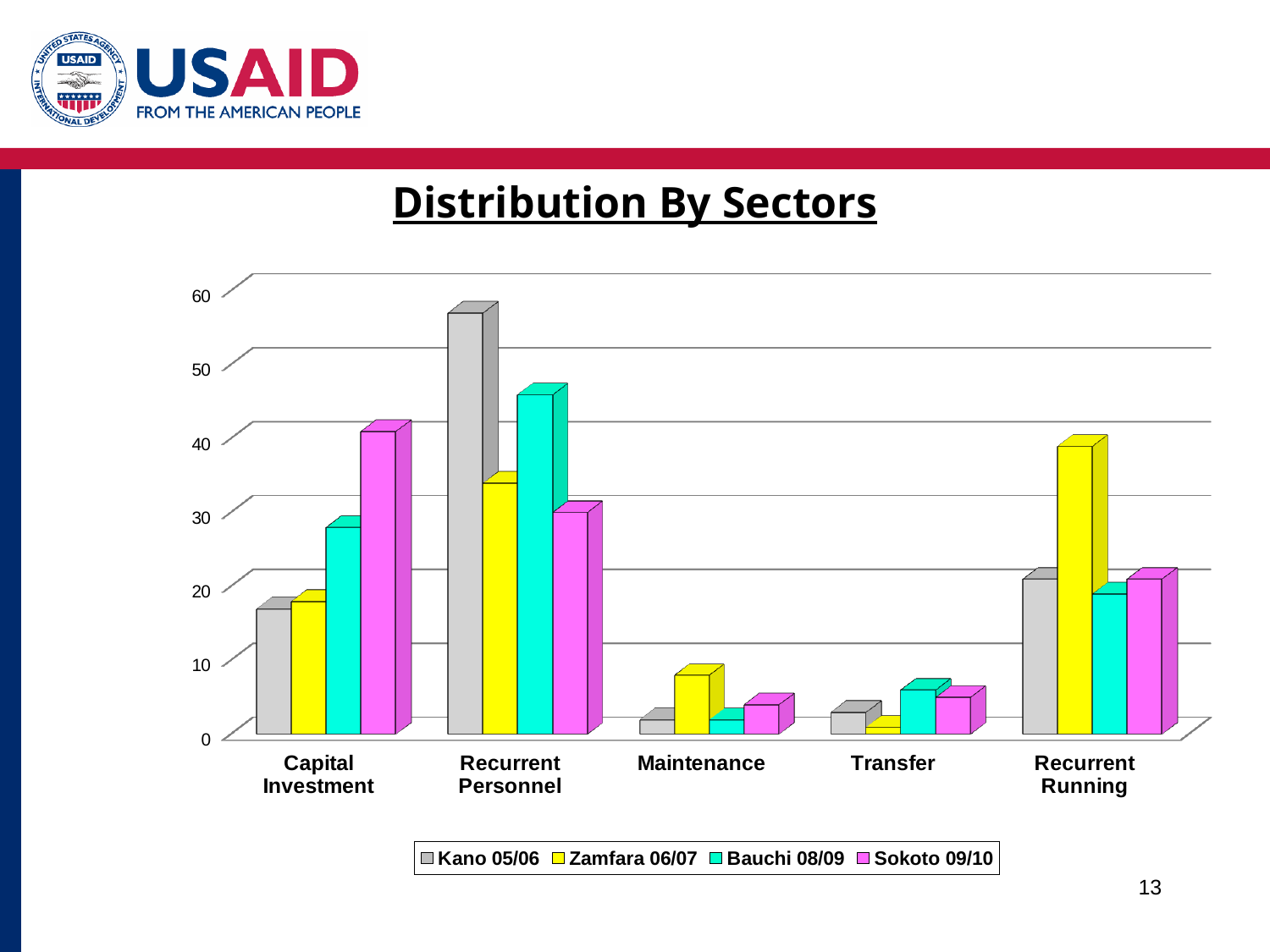
In Recurrent Personnel, which is larger: Kano 05/06 or Bauchi 08/09? Kano 05/06 How many series does the legend list? 4 What is the title of the chart? Distribution By Sectors Which series is shown in yellow in the legend? Zamfara 06/07 What kind of chart is shown on the slide? Bar chart Which sector has the highest value for Kano 05/06? Recurrent Personnel Is the value for Kano 05/06 in Recurrent Personnel greater or less than 50? greater How many sector categories are shown on the x axis? 5 Which sector has the highest value for Zamfara 06/07? Recurrent Running Is the value for Zamfara 06/07 in Maintenance greater or less than 10? less Which sector has the highest value for Sokoto 09/10? Capital Investment